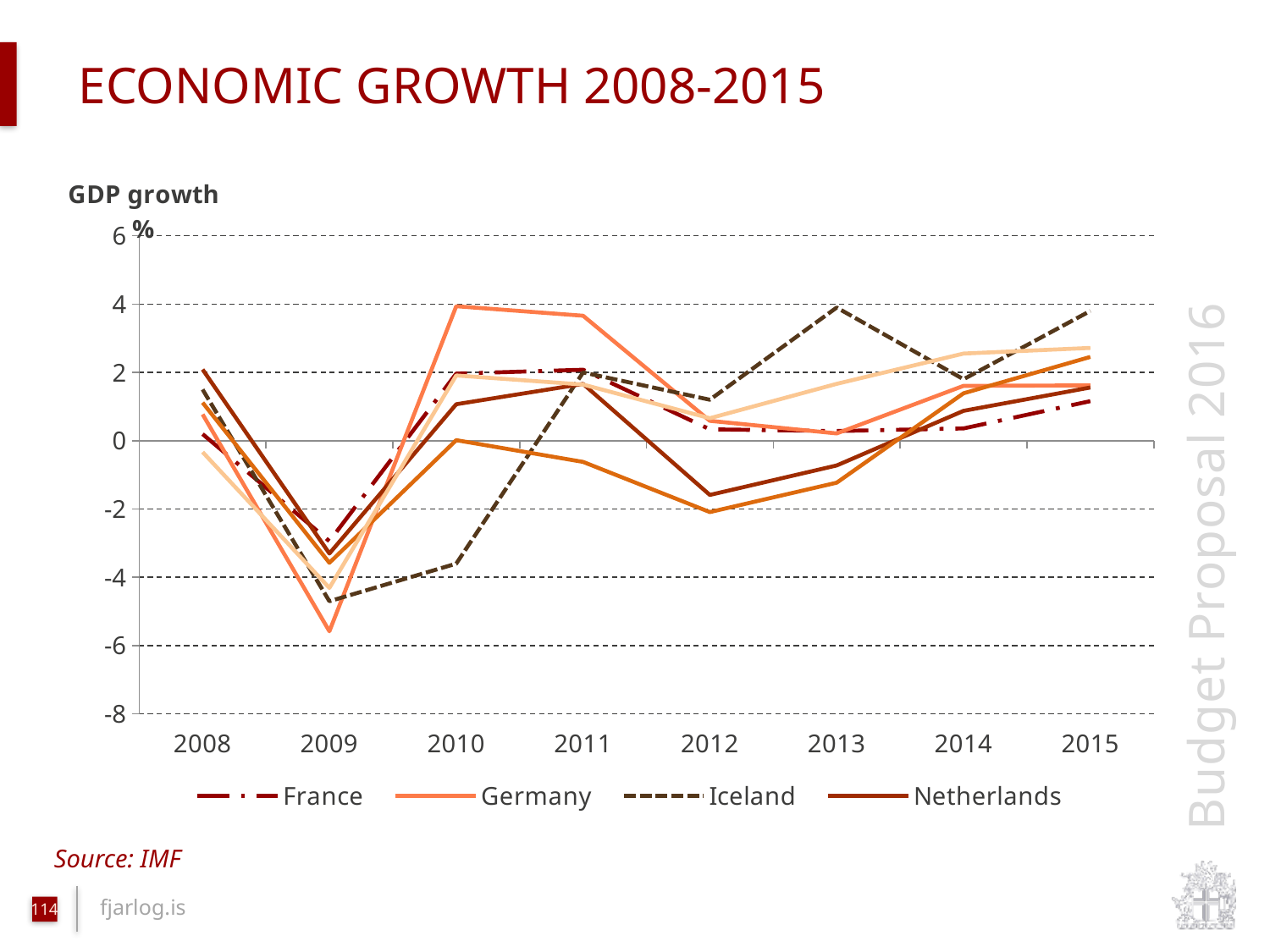
Is the value for Germany in 2009 greater or less than -4? less How many years are shown on the x axis? 8 In which year is Germany's GDP growth lowest? 2009 What source is cited for the chart? IMF How many series does the legend list? 4 Is the value for Iceland in 2010 greater or less than -2? less Is the value for Iceland in 2013 greater or less than 2? greater Does Iceland's GDP growth rise or fall from 2012 to 2013? rise What kind of chart is shown on the slide? line chart What is the title of the chart? GDP growth In 2009, which has the lower value, Germany or France? Germany